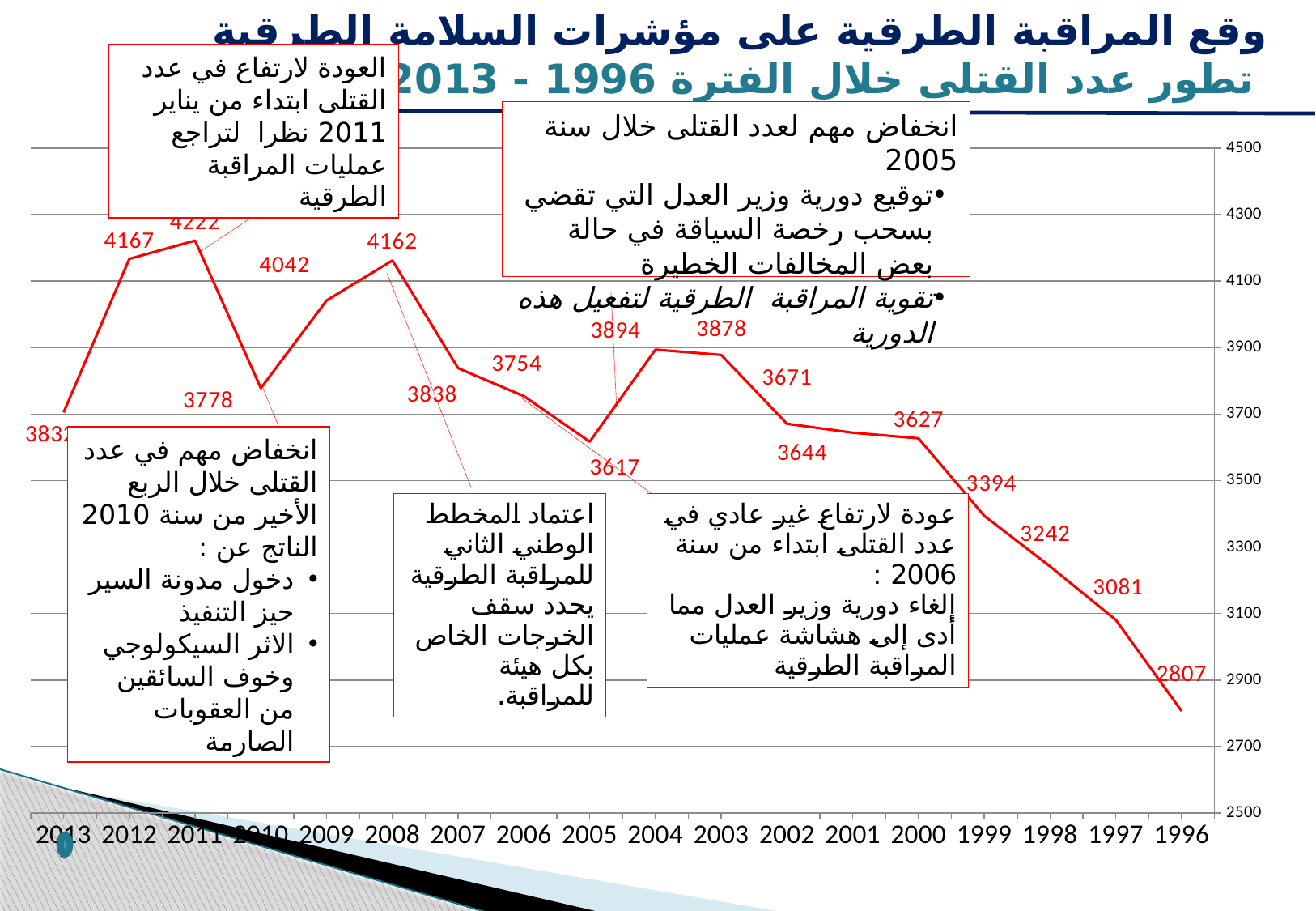
Which year has a larger value, 2004 or 2002? 2004 What is the value plotted for 2008? 4162 What is the number of deaths recorded for 2011? 4222 Which year has the lowest number of deaths? 1996 What is the value plotted for 2005? 3617 How many years are plotted on the x axis? 18 Which year has the highest number of deaths? 2011 What type of chart is shown on the slide? line chart What is the number of deaths recorded for 1996? 2807 Do the values rise or fall from 2000 to 1996 along the x axis? fall What is the difference between the values for 2011 and 2010? 444